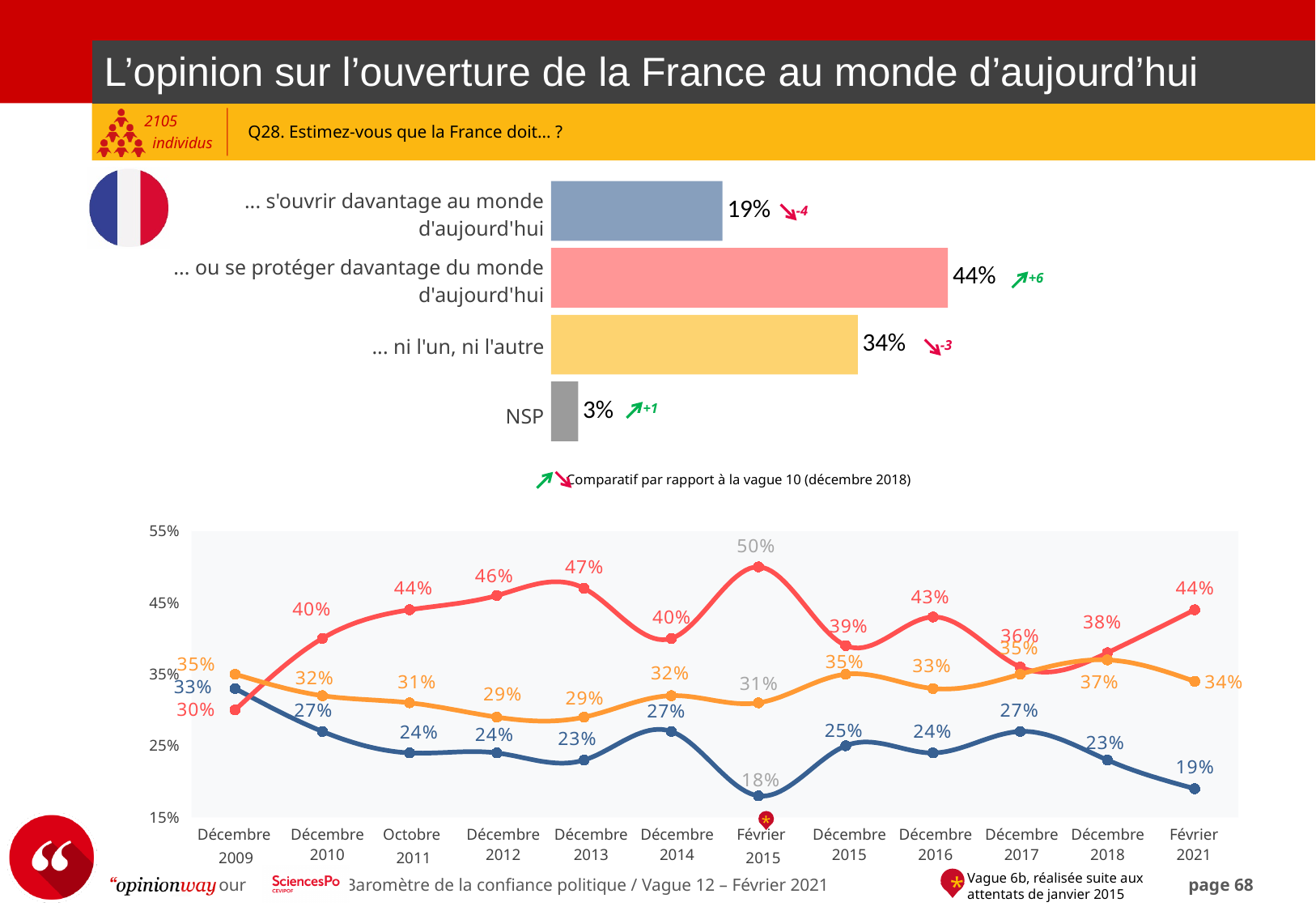
In the bar chart at the top of the slide, what percentage chose "... ou se protéger davantage du monde d'aujourd'hui"? 44% In the bar chart at the top of the slide, which response has the lowest percentage? NSP In the line chart at the bottom of the slide, what is the value of the red line in Février 2015? 50% How many response categories are shown in the bar chart at the top of the slide? 4 In the line chart at the bottom of the slide, which is larger in Décembre 2009: the red line or the blue line? The blue line (33%) In the bar chart at the top of the slide, what percentage chose "... s'ouvrir davantage au monde d'aujourd'hui"? 19% How many time points are plotted on the x axis of the line chart at the bottom of the slide? 12 In the line chart at the bottom of the slide, at which date does the red line reach its highest value? Février 2015 What kind of chart is the chart at the bottom of the slide? Line chart In the bar chart at the top of the slide, which response has the highest percentage? ... ou se protéger davantage du monde d'aujourd'hui In the bar chart at the top of the slide, what is the difference between "... ou se protéger davantage du monde d'aujourd'hui" and "... ni l'un, ni l'autre"? 10 percentage points In the line chart at the bottom of the slide, what is the value of the blue line in Février 2015? 18%